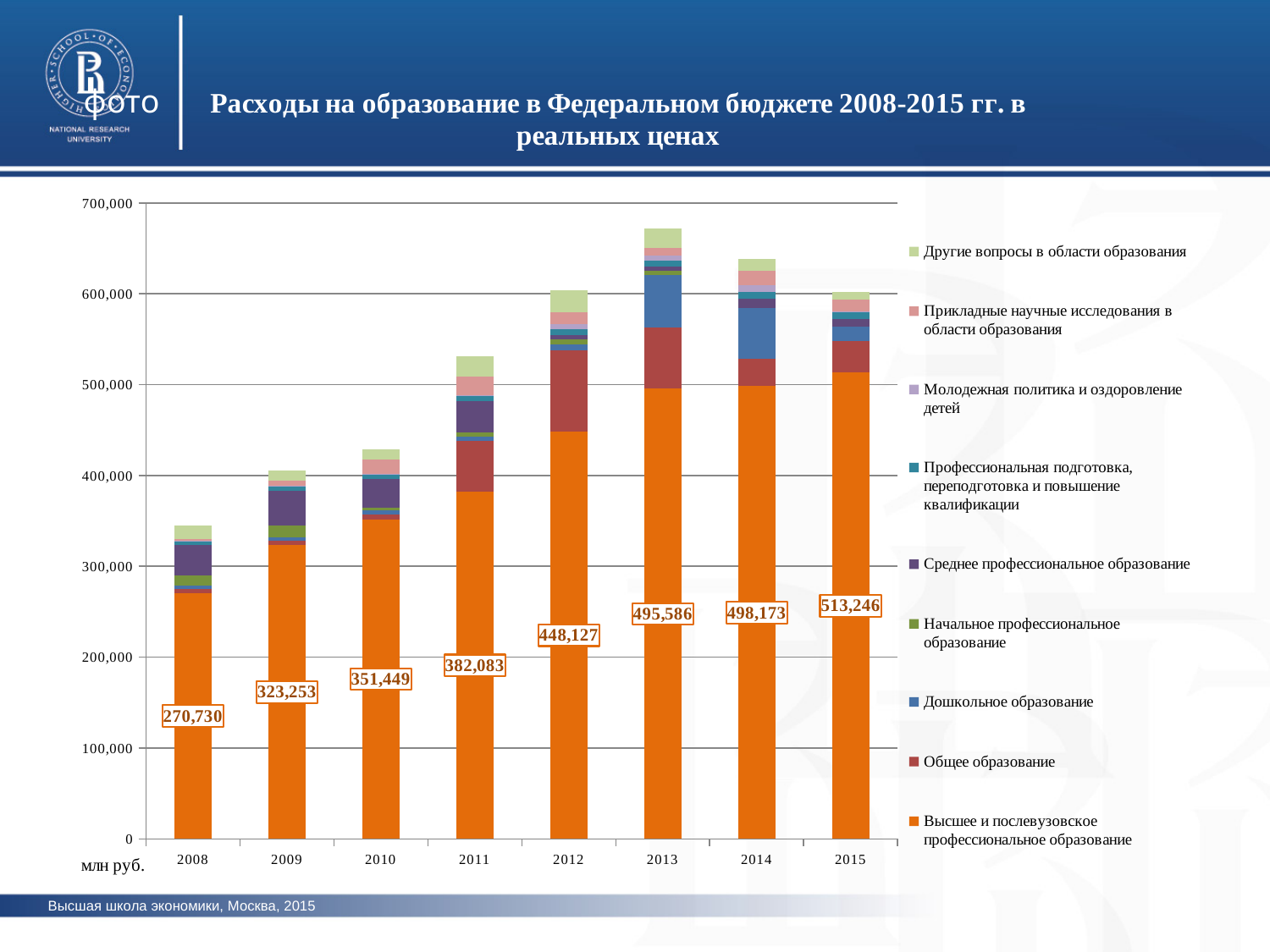
What is the value of the Высшее и послевузовское профессиональное образование series for 2015? 513,246 Is the total height of the stacked bar for 2013 greater or less than 600,000? greater How many series does the legend list? 9 What is the value of the Высшее и послевузовское профессиональное образование series for 2012? 448,127 How many years are shown on the x axis? 8 What is the difference between the Высшее и послевузовское профессиональное образование values for 2015 and 2014? 15,073 In which year is the labelled Высшее и послевузовское профессиональное образование value the highest? 2015 In which year is the labelled Высшее и послевузовское профессиональное образование value the lowest? 2008 Is the total height of the stacked bar for 2008 greater or less than 400,000? less Which year has the larger Высшее и послевузовское профессиональное образование value, 2010 or 2011? 2011 What is the value of the Высшее и послевузовское профессиональное образование series for 2008? 270,730 What kind of chart is shown on the slide? Stacked bar chart